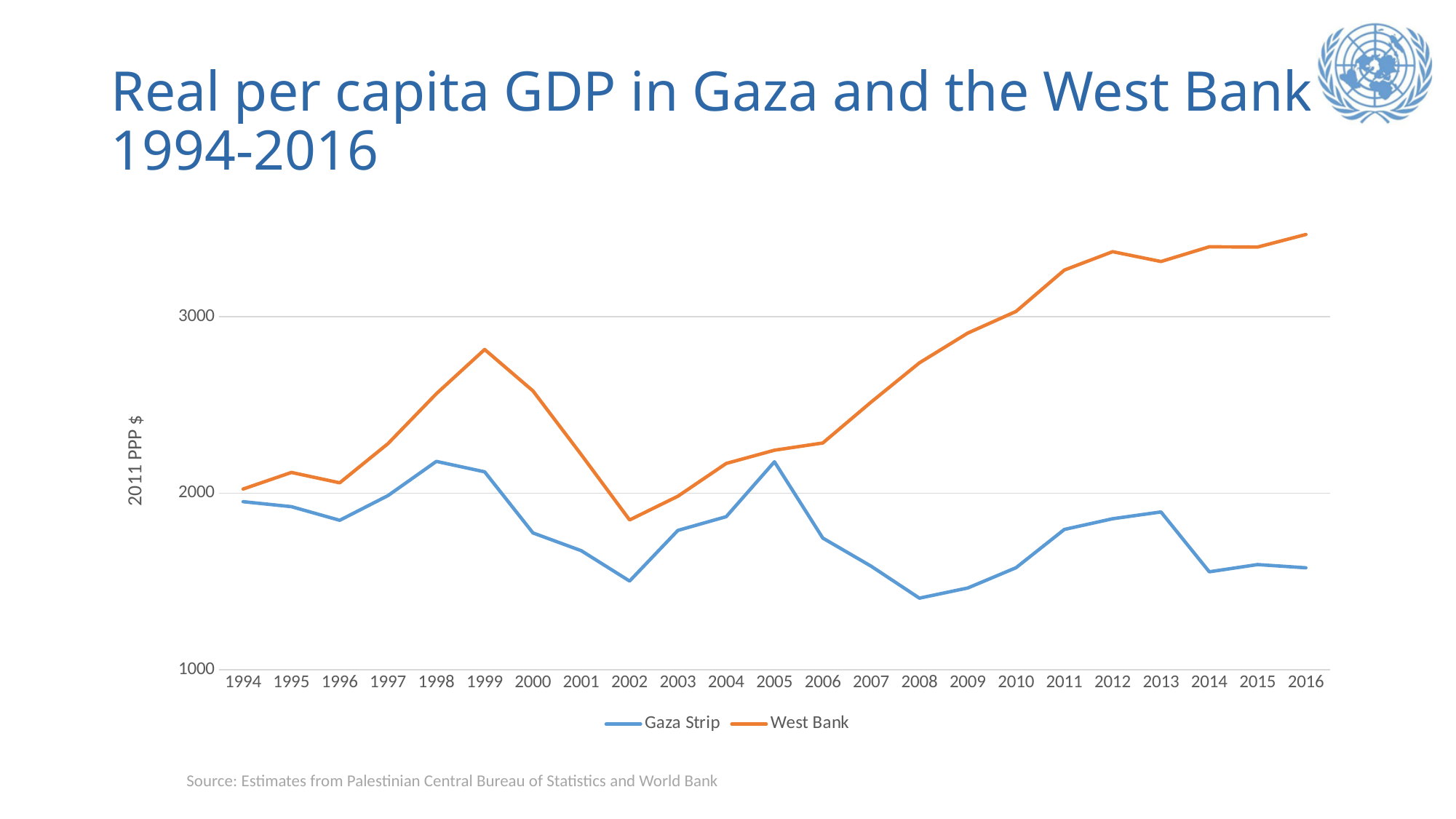
In which year is the West Bank value highest? 2016 What kind of chart is shown on the slide? Line chart How many years are plotted along the x axis? 23 Does the West Bank line rise or fall from 2002 to 2016? Rise Is the value for the West Bank in 2016 greater or less than 3000? greater Which series has the larger value in 2016, Gaza Strip or West Bank? West Bank Is the value for the Gaza Strip in 2008 greater or less than 2000? less Is the value for the West Bank in 2002 greater or less than 2000? less In which year is the Gaza Strip value lowest? 2008 How many series does the legend list? 2 What is the label on the y axis? 2011 PPP $